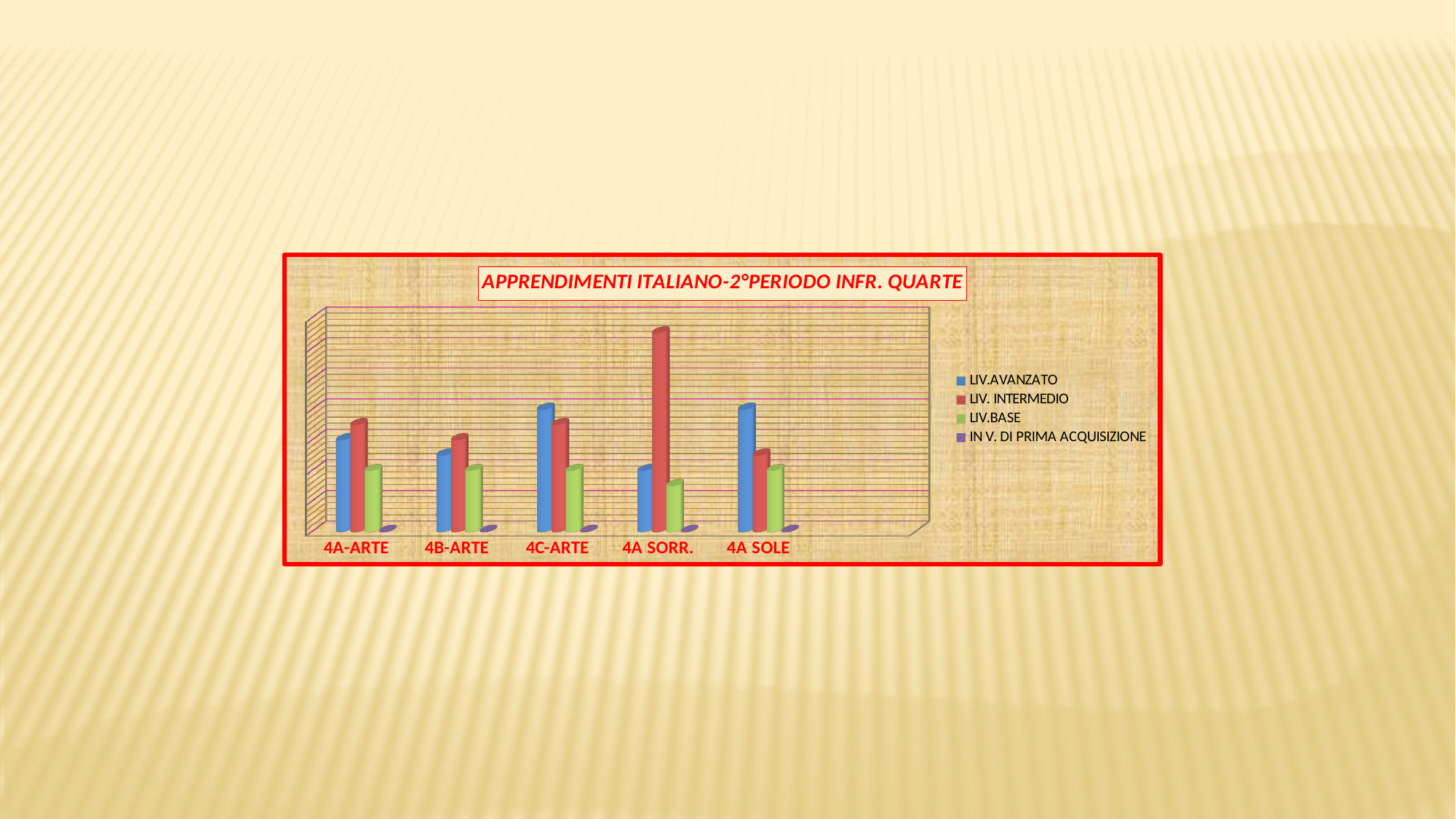
For 4A-ARTE, which is larger: LIV.AVANZATO or LIV. INTERMEDIO? LIV. INTERMEDIO Which category has the tallest LIV. INTERMEDIO bar? 4A SORR. Which colour represents the LIV.BASE series in the chart? green Which category has the shortest LIV.AVANZATO bar? 4A SORR. Which series has the lowest bars in every category? IN V. DI PRIMA ACQUISIZIONE How many categories (classes) are shown along the x axis of the chart? 5 For 4A SORR., which is larger: LIV. INTERMEDIO or LIV.AVANZATO? LIV. INTERMEDIO What is the title of the chart? APPRENDIMENTI ITALIANO-2°PERIODO INFR. QUARTE For 4A SOLE, which is larger: LIV.AVANZATO or LIV. INTERMEDIO? LIV.AVANZATO What kind of chart is shown on the slide? bar chart How many series does the chart's legend list? 4